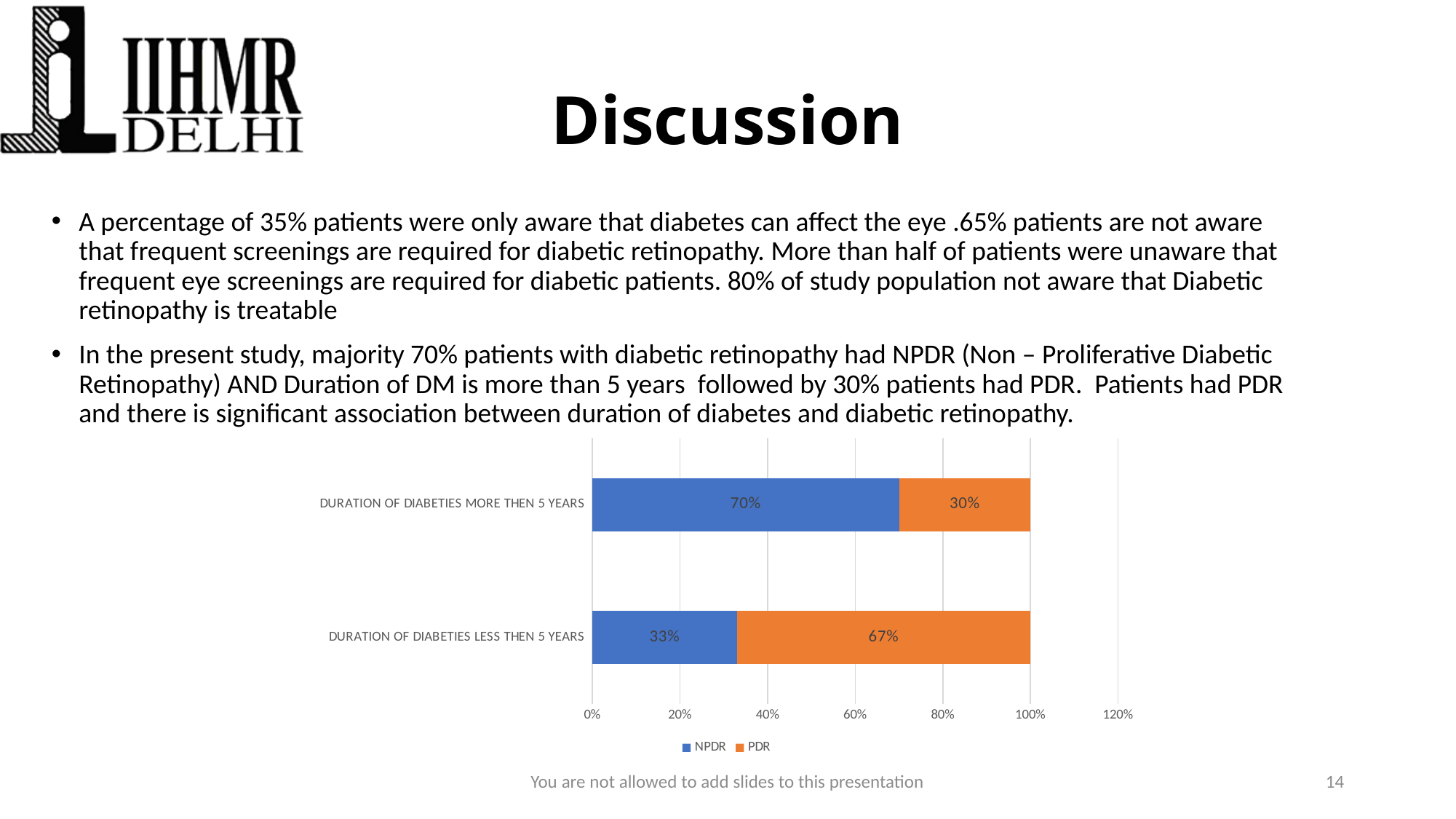
For duration of diabetes less than 5 years, which is larger, NPDR or PDR? PDR What is the PDR value for duration of diabetes less than 5 years? 67% Which duration category has the lower PDR value? Duration of diabetes more than 5 years How many duration categories are shown in the chart? 2 How many series does the legend list? 2 What kind of chart is shown on the slide? Stacked bar chart What is the PDR value for duration of diabetes more than 5 years? 30% What is the difference between the NPDR values for more than 5 years and less than 5 years? 37% What is the NPDR value for duration of diabetes less than 5 years? 33% Which duration category has the higher NPDR value? Duration of diabetes more than 5 years What is the NPDR value for duration of diabetes more than 5 years? 70% What is the total of the stacked bar for duration of diabetes more than 5 years? 100%